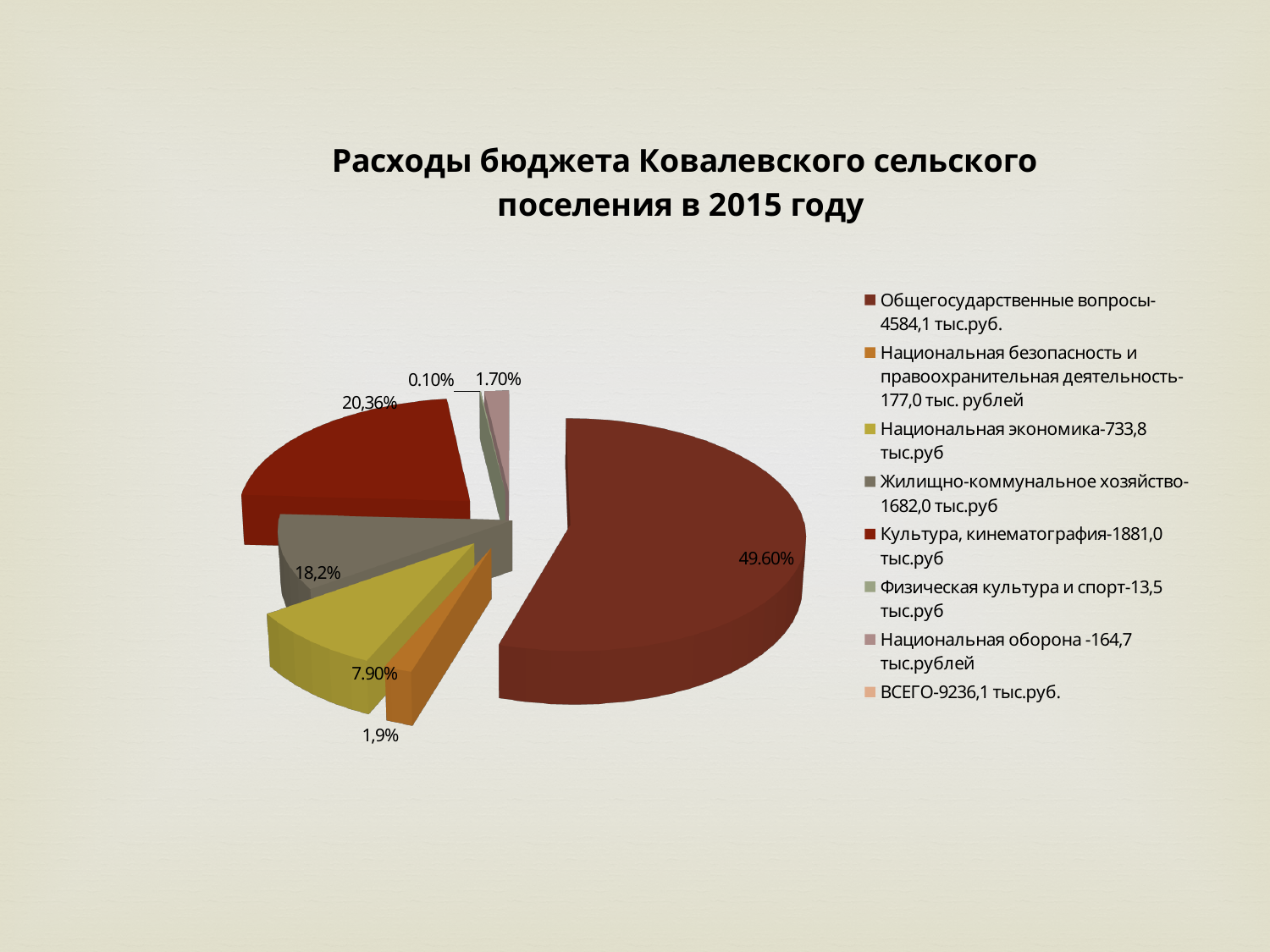
Which category has the largest slice of the pie? Общегосударственные вопросы What is the title of the chart? Расходы бюджета Ковалевского сельского поселения в 2015 году Which category has the smallest labelled slice of the pie? Физическая культура и спорт What percentage is shown for the slice Культура, кинематография? 20,36% What percentage is shown for the slice Физическая культура и спорт? 0.10% What percentage is shown for the slice Национальная оборона? 1.70% Which slice is larger: Культура, кинематография or Жилищно-коммунальное хозяйство? Культура, кинематография What percentage is shown for the slice Жилищно-коммунальное хозяйство? 18,2% What percentage is shown for the slice Национальная экономика? 7.90% How many entries does the legend list? 8 What percentage is shown for the slice Общегосударственные вопросы? 49.60% What kind of chart is shown on the slide? pie chart